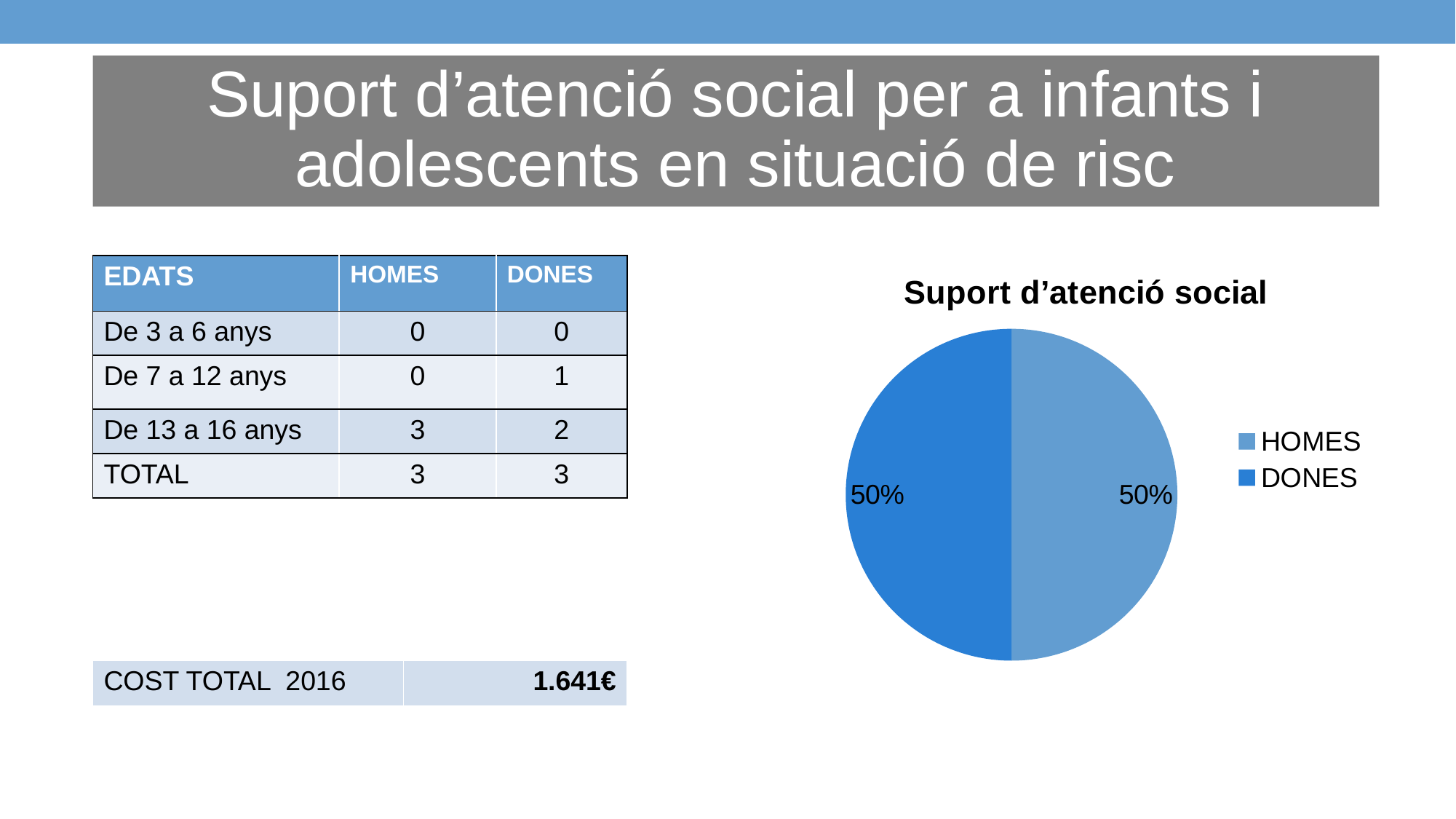
What is the title of the chart? Suport d'atenció social What is the difference between the HOMES share and the DONES share in the pie chart? 0% How many slices does the pie chart have? 2 What is the data label shown on the HOMES slice? 50% What share of the pie does DONES represent? 50% What kind of chart is shown on the slide? pie chart How many entries does the chart legend list? 2 What is the data label shown on the DONES slice? 50% What share of the pie does HOMES represent? 50% Which legend entries are shown in the pie chart? HOMES and DONES